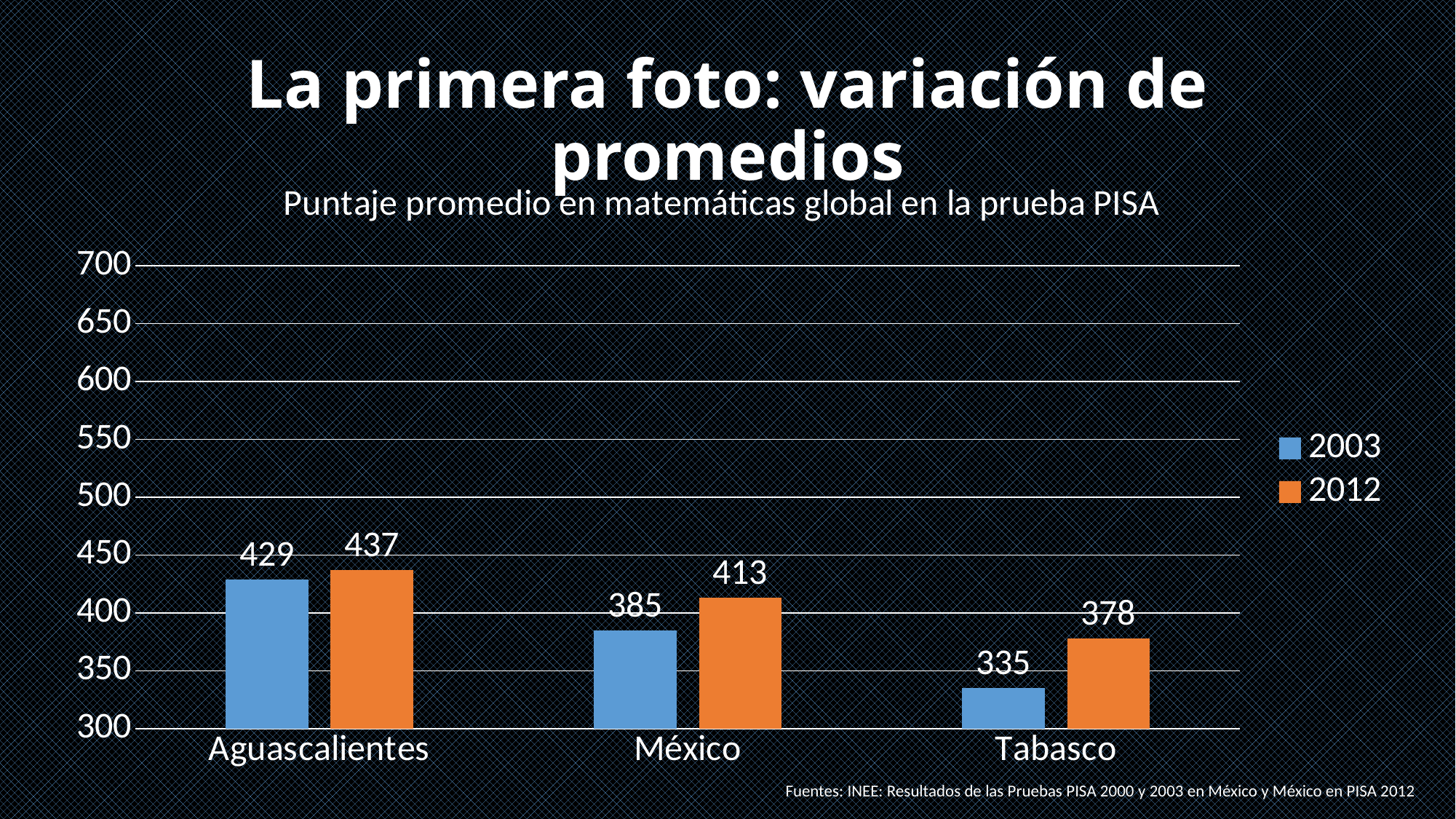
What is the 2012 value for México? 413 Which category has the highest 2012 value? Aguascalientes How many series does the legend list? 2 Which is larger, the 2003 value for México or the 2012 value for Tabasco? 2003 value for México What is the difference between the 2012 and 2003 values for Tabasco? 43 Is the 2003 value for Tabasco greater or less than 350? less How many categories are shown on the x axis? 3 What is the 2012 value for Tabasco? 378 What is the difference between the 2012 and 2003 values for México? 28 What is the 2003 value for Aguascalientes? 429 Which category has the lowest 2003 value? Tabasco What kind of chart is shown on the slide? bar chart